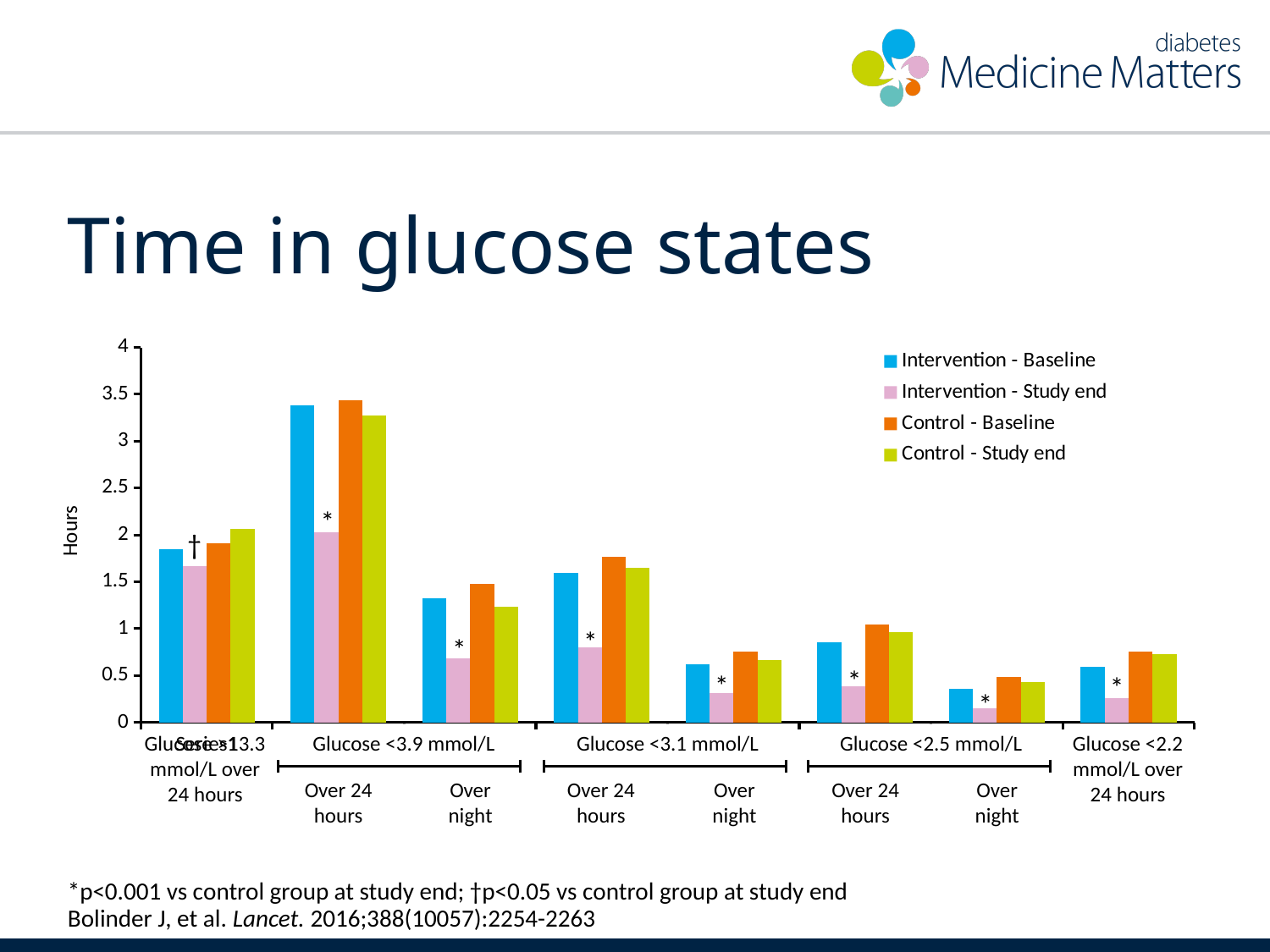
For Glucose <3.9 mmol/L over 24 hours, which is larger: Intervention - Baseline or Intervention - Study end? Intervention - Baseline For Glucose >13.3 mmol/L over 24 hours, which is larger: Control - Study end or Intervention - Study end? Control - Study end Is the Intervention - Baseline value for Glucose <3.9 mmol/L over 24 hours greater or less than 3? greater What kind of chart is shown on the slide? Bar chart Is the Intervention - Study end value for Glucose <3.9 mmol/L over 24 hours greater or less than 2.5? less How many series does the legend list? 4 Is the Intervention - Study end value for Glucose <2.5 mmol/L over night greater or less than 0.5? less Which series is shown in green in the legend? Control - Study end How many groups of bars are plotted along the x axis? 8 In which category is the Control - Baseline bar the highest? Glucose <3.9 mmol/L over 24 hours What is the label on the y axis? Hours